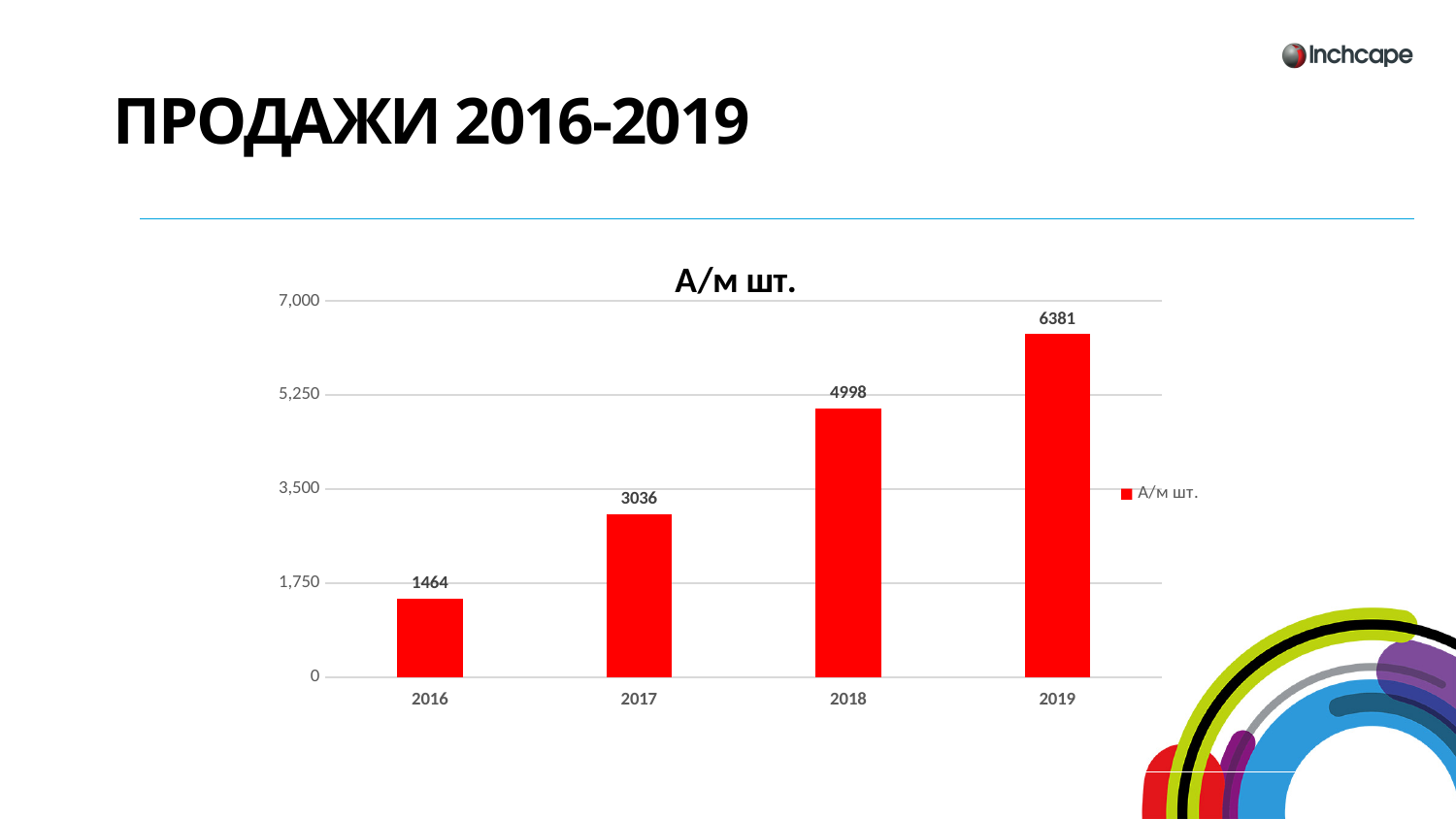
Which year has the highest value? 2019 What is the value for 2016? 1464 How many years are shown on the x axis? 4 What is the value for 2019? 6381 Which year has the lowest value? 2016 Do the values rise or fall from 2016 to 2019? rise What is the value for 2017? 3036 What kind of chart is shown? bar chart Which is larger, the value for 2017 or the value for 2018? 2018 What is the value for 2018? 4998 Is the value for 2019 greater or less than 5,250? greater What is the difference between the values for 2019 and 2016? 4917